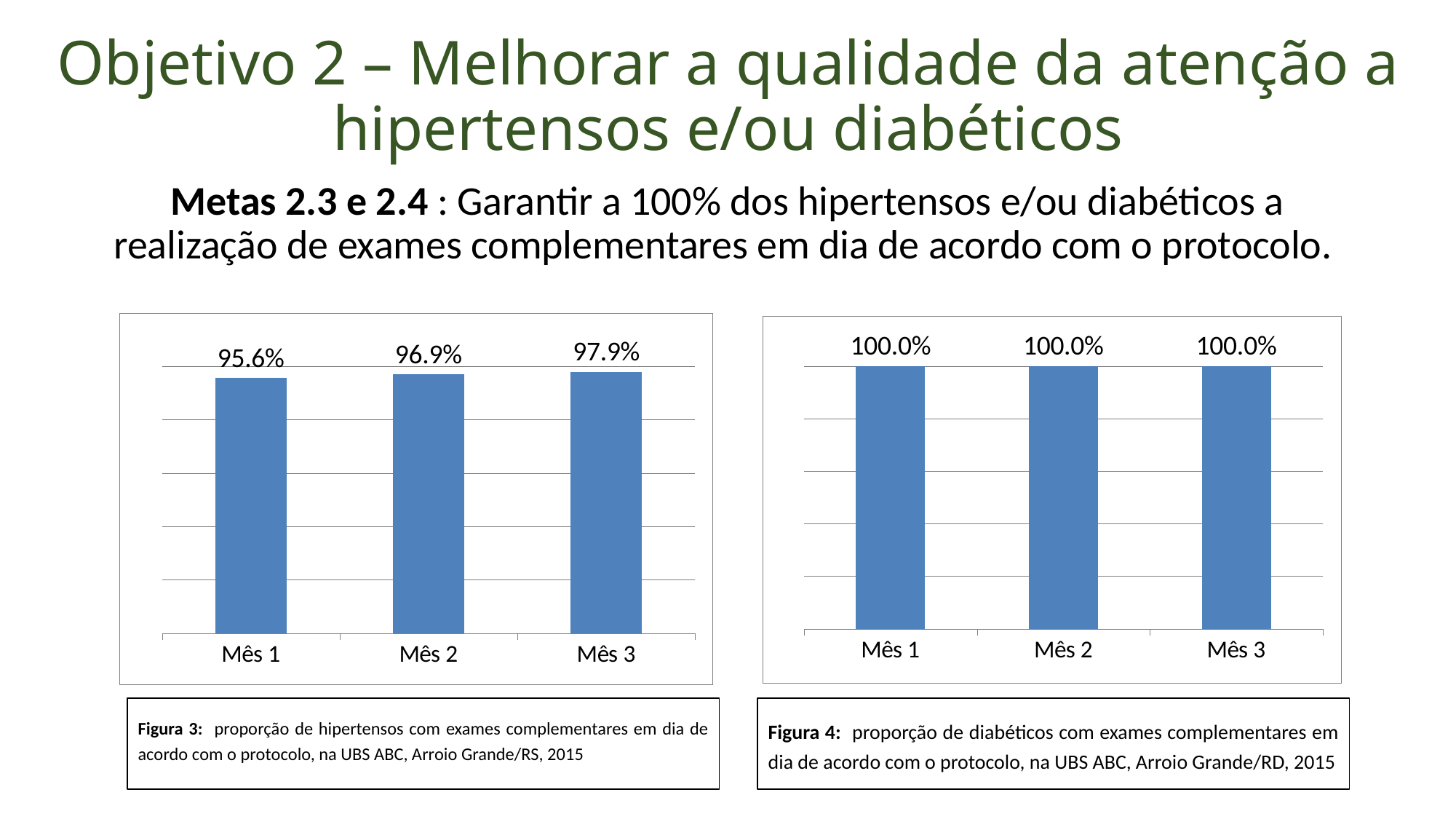
In the left chart (Figura 3, hipertensos), what is the value for Mês 1? 95.6% What kind of chart is the right chart (Figura 4, diabéticos)? bar chart In the left chart (Figura 3, hipertensos), what is the value for Mês 3? 97.9% In the left chart (Figura 3, hipertensos), what is the value for Mês 2? 96.9% In the right chart (Figura 4, diabéticos), how many months are shown? 3 In the left chart (Figura 3, hipertensos), which month has the highest value? Mês 3 In the left chart (Figura 3, hipertensos), what is the difference between the values for Mês 3 and Mês 1? 2.3% In the left chart (Figura 3, hipertensos), do the values rise or fall from Mês 1 to Mês 3? rise In the left chart (Figura 3, hipertensos), which month has the lowest value? Mês 1 In the left chart (Figura 3, hipertensos), which is larger, the value for Mês 2 or Mês 1? Mês 2 In the right chart (Figura 4, diabéticos), what is the difference between the values for Mês 3 and Mês 1? 0.0% In the right chart (Figura 4, diabéticos), what is the value for Mês 2? 100.0%